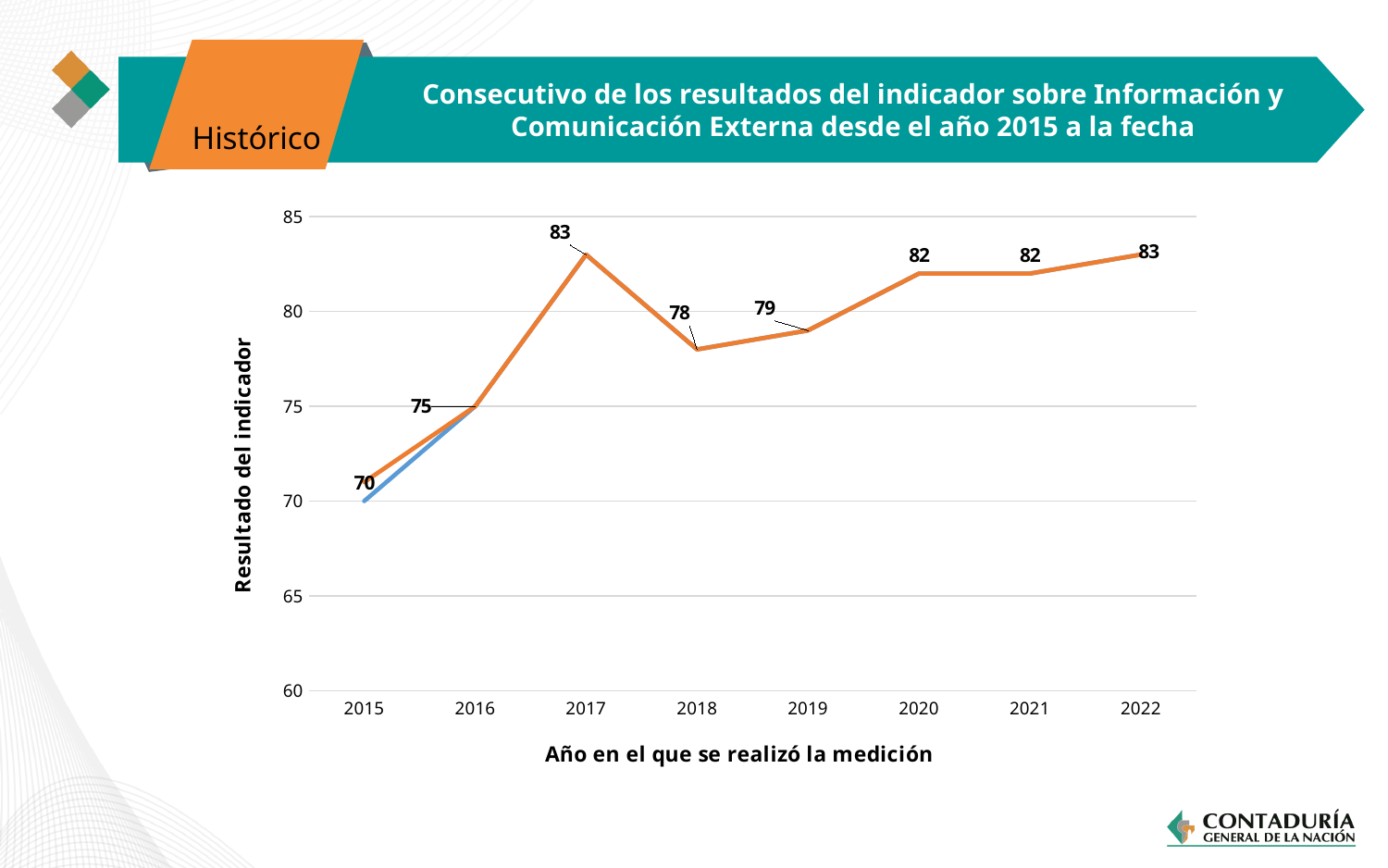
Does the indicator value rise or fall from 2015 to 2017? rise Which is larger, the value for 2018 or the value for 2020? 2020 What is the label of the y axis? Resultado del indicador How many years are plotted on the x axis? 8 What is the difference between the indicator values for 2017 and 2018? 5 Which year has the lowest indicator value? 2015 What is the value of the indicator for 2019? 79 What is the value of the indicator for 2021? 82 What is the value of the indicator for 2017? 83 What kind of chart is shown on the slide? line chart What is the difference between the indicator values for 2016 and 2015? 5 What is the value of the indicator for 2015? 70